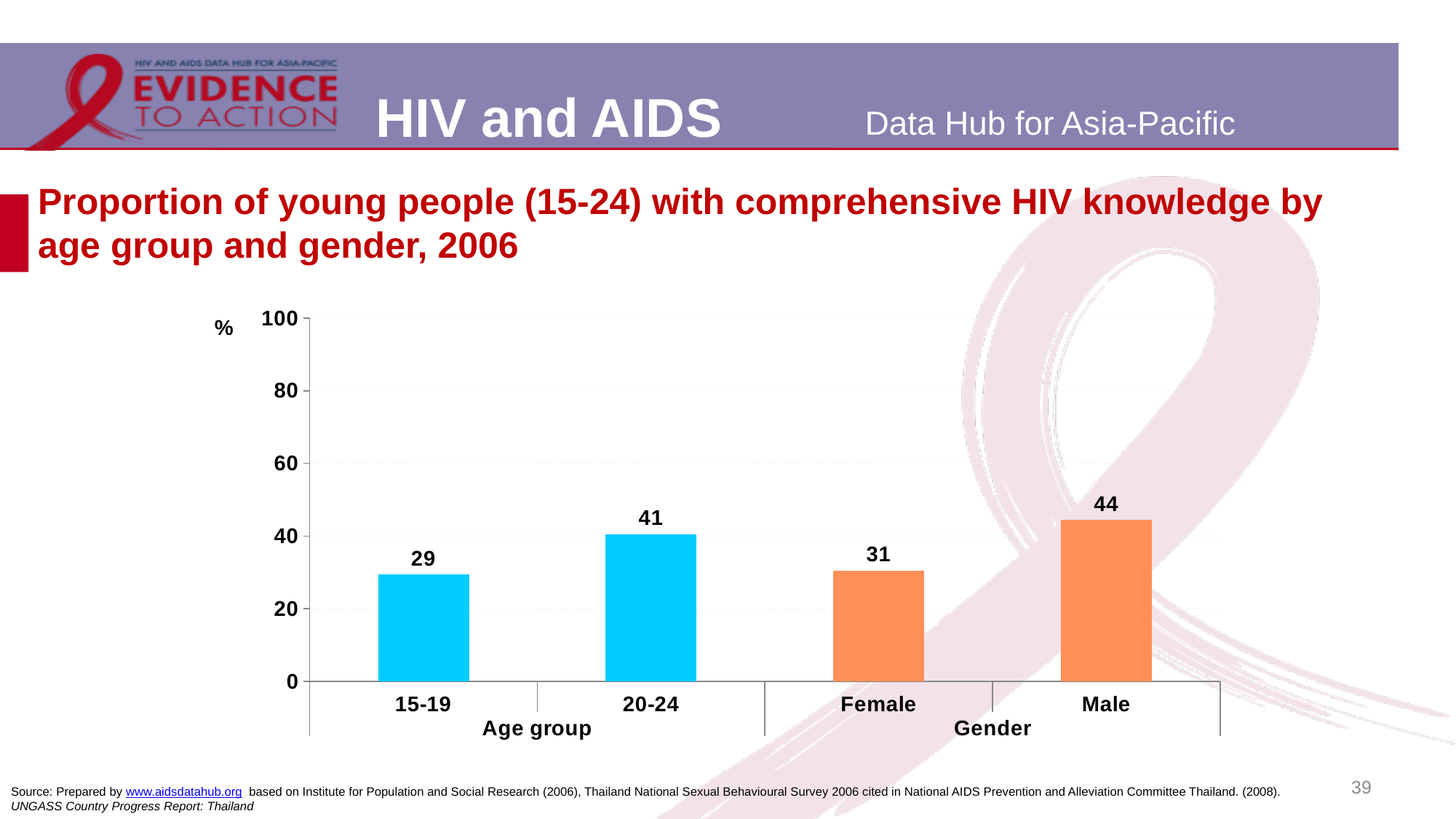
What is the value for the 20-24 age group? 41 What is the value for Male? 44 Which is larger, the value for 20-24 or the value for Female? 20-24 What is the value for Female? 31 Which category has the lowest value? 15-19 What is the value for the 15-19 age group? 29 What unit is shown on the vertical axis of the chart? % How many bars are plotted in the chart? 4 What kind of chart is shown on the slide? Bar chart What is the difference between the values for Male and Female? 13 What is the difference between the values for the 20-24 and 15-19 age groups? 12 Which category has the highest value? Male